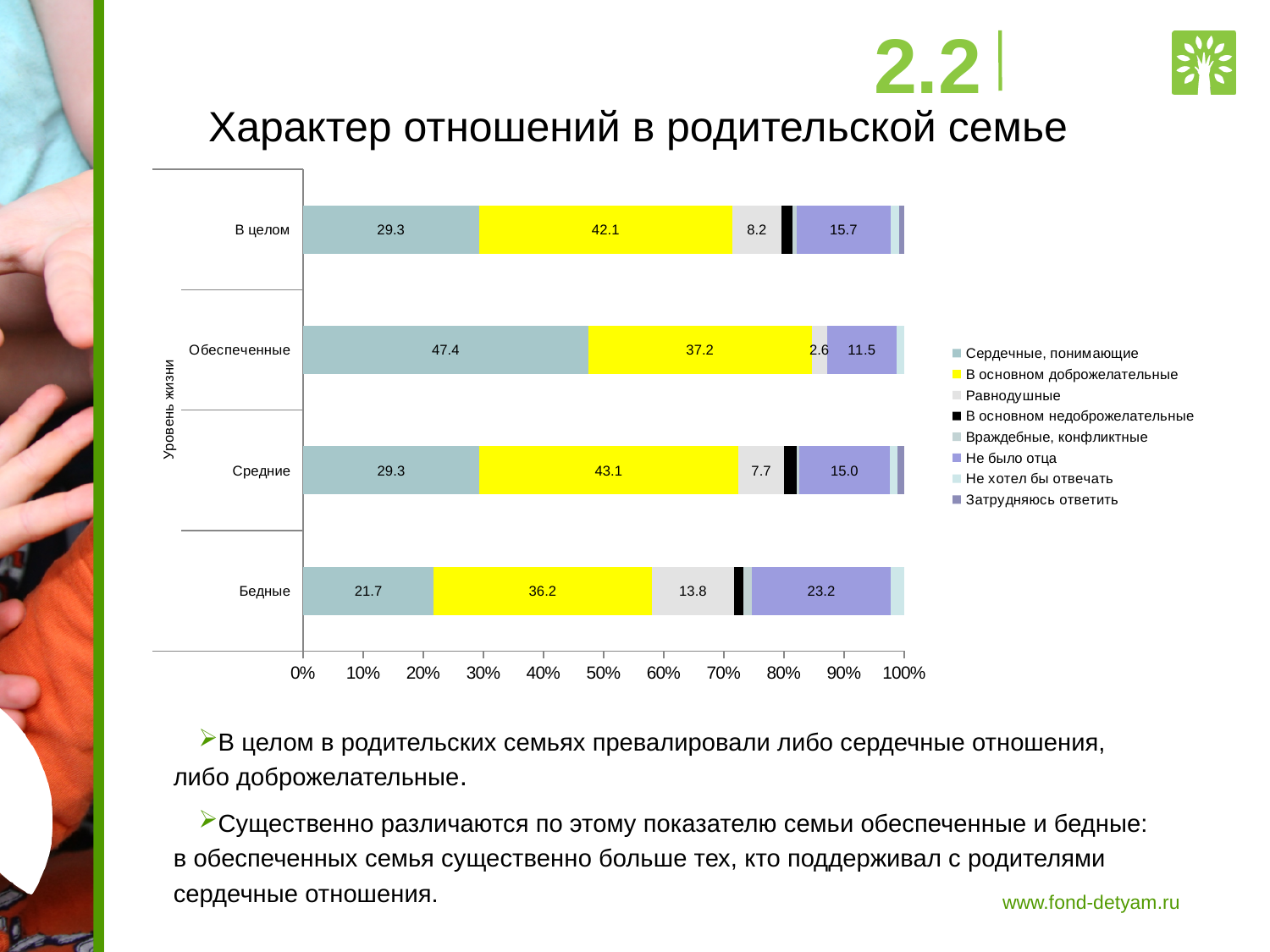
What is the title of the chart? Характер отношений в родительской семье What is the value of 'Равнодушные' for the 'Средние' category? 7.7 What is the value of 'Не было отца' for the 'В целом' category? 15.7 What is the value of 'В основном доброжелательные' for the 'Бедные' category? 36.2 Which is larger: the 'Не было отца' value for 'Бедные' or for 'Средние'? Бедные What is the value of 'Сердечные, понимающие' for the 'Обеспеченные' category? 47.4 What type of chart is shown on the slide? stacked bar chart How many series does the legend list? 8 Which category has the highest value for 'Сердечные, понимающие'? Обеспеченные What is the difference between the 'Сердечные, понимающие' values for 'Обеспеченные' and 'Бедные'? 25.7 Which category has the lowest value for 'Равнодушные'? Обеспеченные How many categories are shown on the vertical axis of the chart? 4